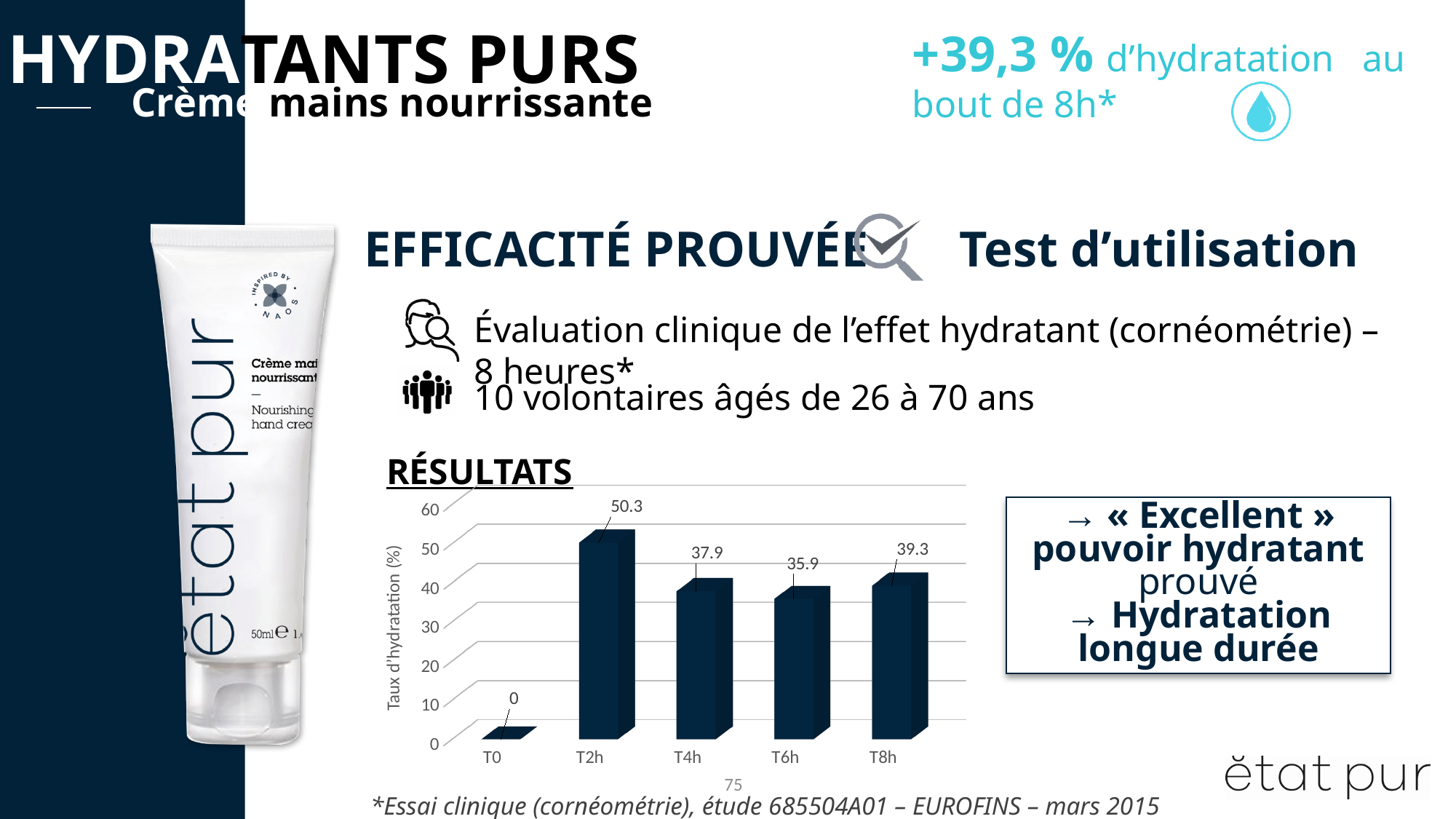
Which time point has the highest hydration rate? T2h Is the value at T4h greater or less than 40? less What is the hydration rate value at T6h? 35.9 How many time points are plotted on the chart? 5 What is the hydration rate value at T2h? 50.3 Which time point has the lowest hydration rate? T0 What is the hydration rate value at T8h? 39.3 Which is larger, the value at T4h or the value at T6h? T4h What is the label of the vertical axis? Taux d'hydratation (%) What is the value shown for T0? 0 What kind of chart is shown under RÉSULTATS? bar chart What is the difference between the values at T2h and T8h? 11